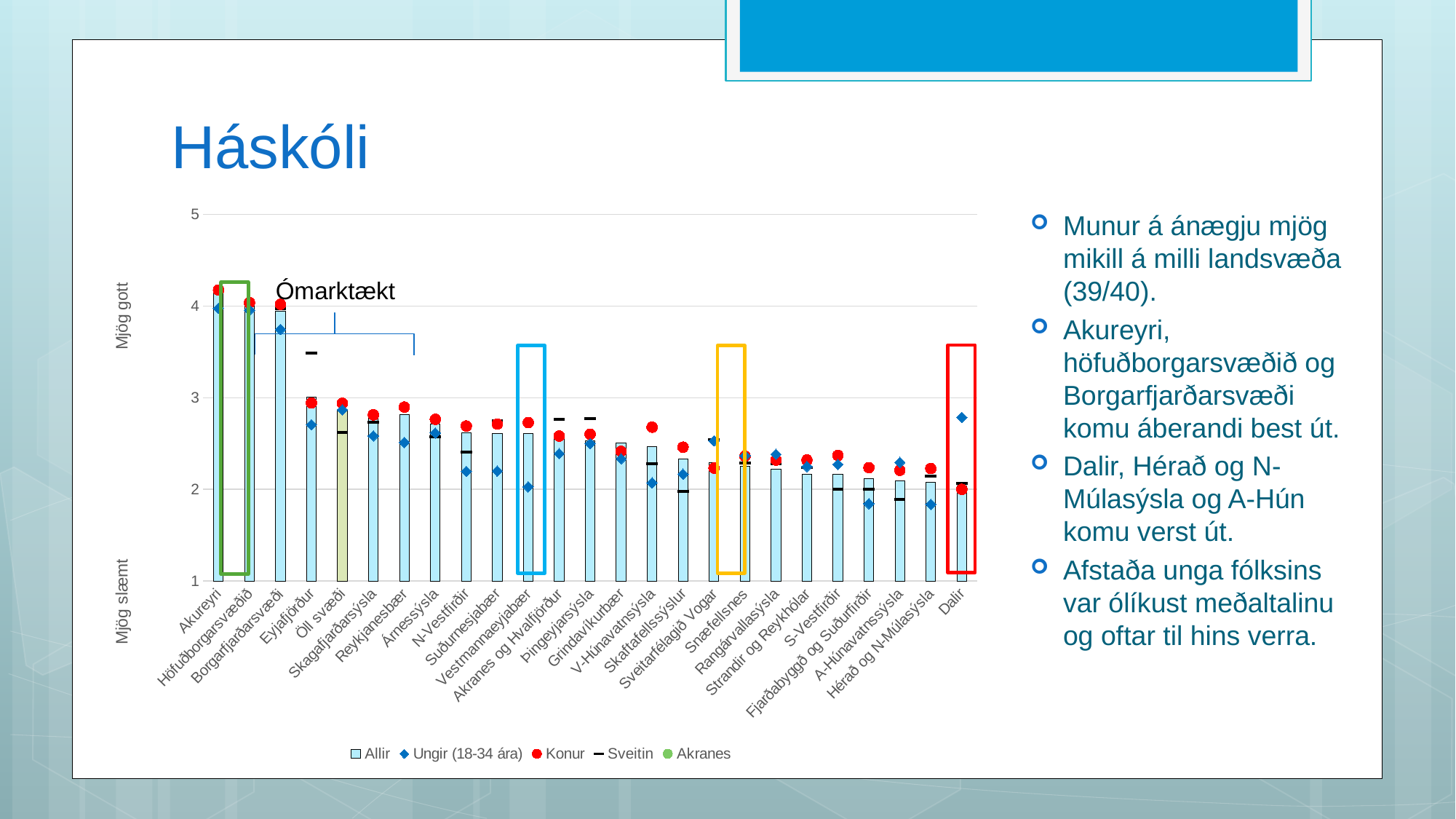
What kind of chart is shown on the slide? Bar chart How many series does the chart legend list? 5 Is the 'Allir' value for Borgarfjarðarsvæði greater or less than 3? greater Is the 'Allir' value for Dalir greater or less than 3? less Is the 'Allir' value for Akureyri greater or less than 4? greater Do the 'Allir' bar values generally rise or fall from left to right along the x axis? Fall How many regions (categories) are shown along the x axis of the chart? 25 Which region has the lowest 'Allir' bar in the chart? Dalir Which is larger for Dalir: the 'Ungir (18-34 ára)' value or the 'Konur' value? Ungir (18-34 ára) What is the title of the slide containing the chart? Háskóli Which region has the highest 'Allir' bar in the chart? Akureyri